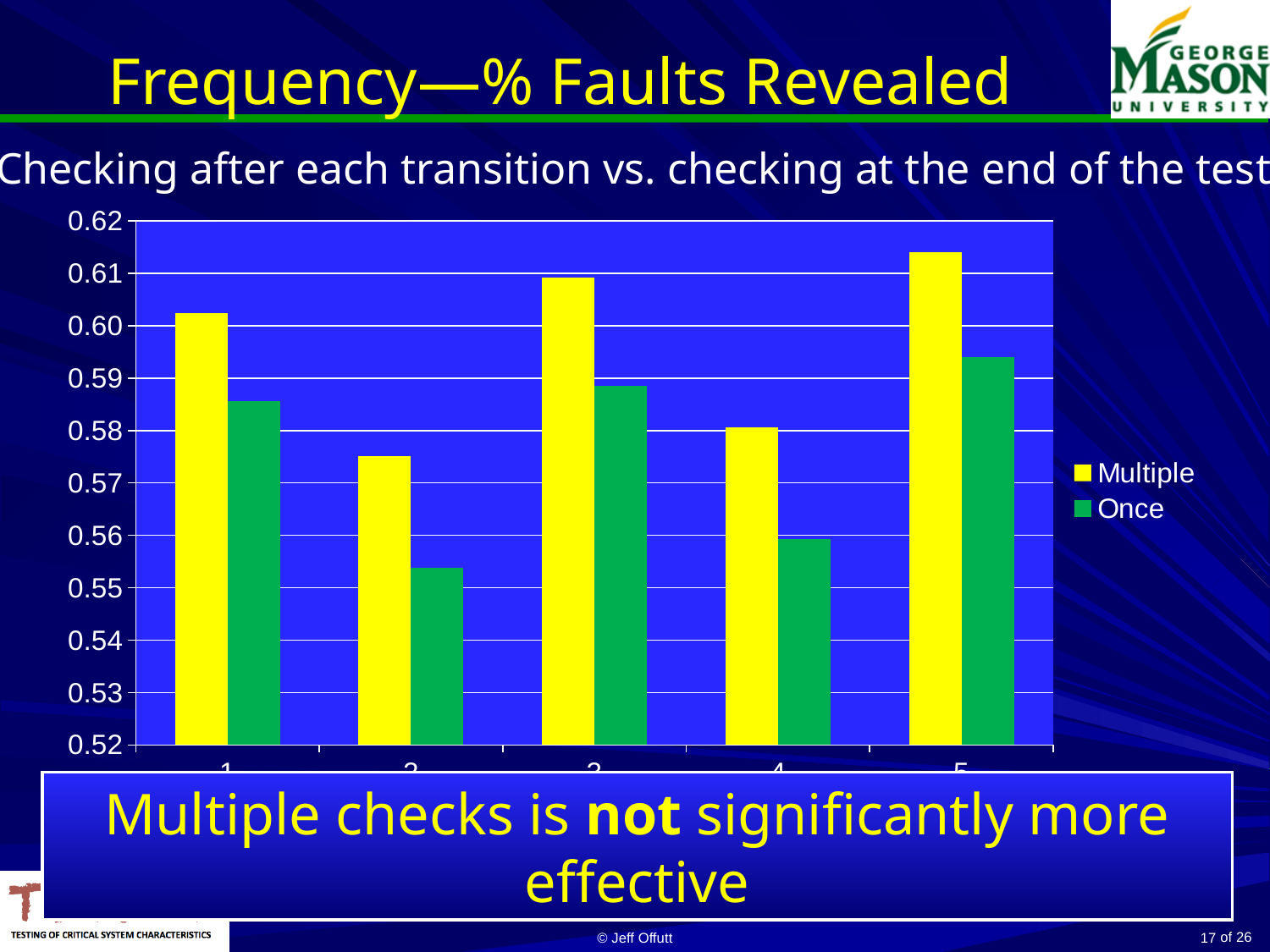
What kind of chart is shown on the slide? bar chart What colour are the bars for the Multiple series? yellow In the first group, which series has the larger value, Multiple or Once? Multiple How many groups of bars are plotted along the x axis? 5 Is the Once value in the fourth group greater or less than 0.57? less Is the Once value in the second group greater or less than 0.56? less Which group has the highest value for the Once series? the fifth group Is the Multiple value in the fifth group greater or less than 0.61? greater Which group has the lowest value for the Multiple series? the second group Which group has the highest value for the Multiple series? the fifth group Which is larger, the Multiple value in the third group or the Multiple value in the fourth group? the third group How many series does the legend list? 2